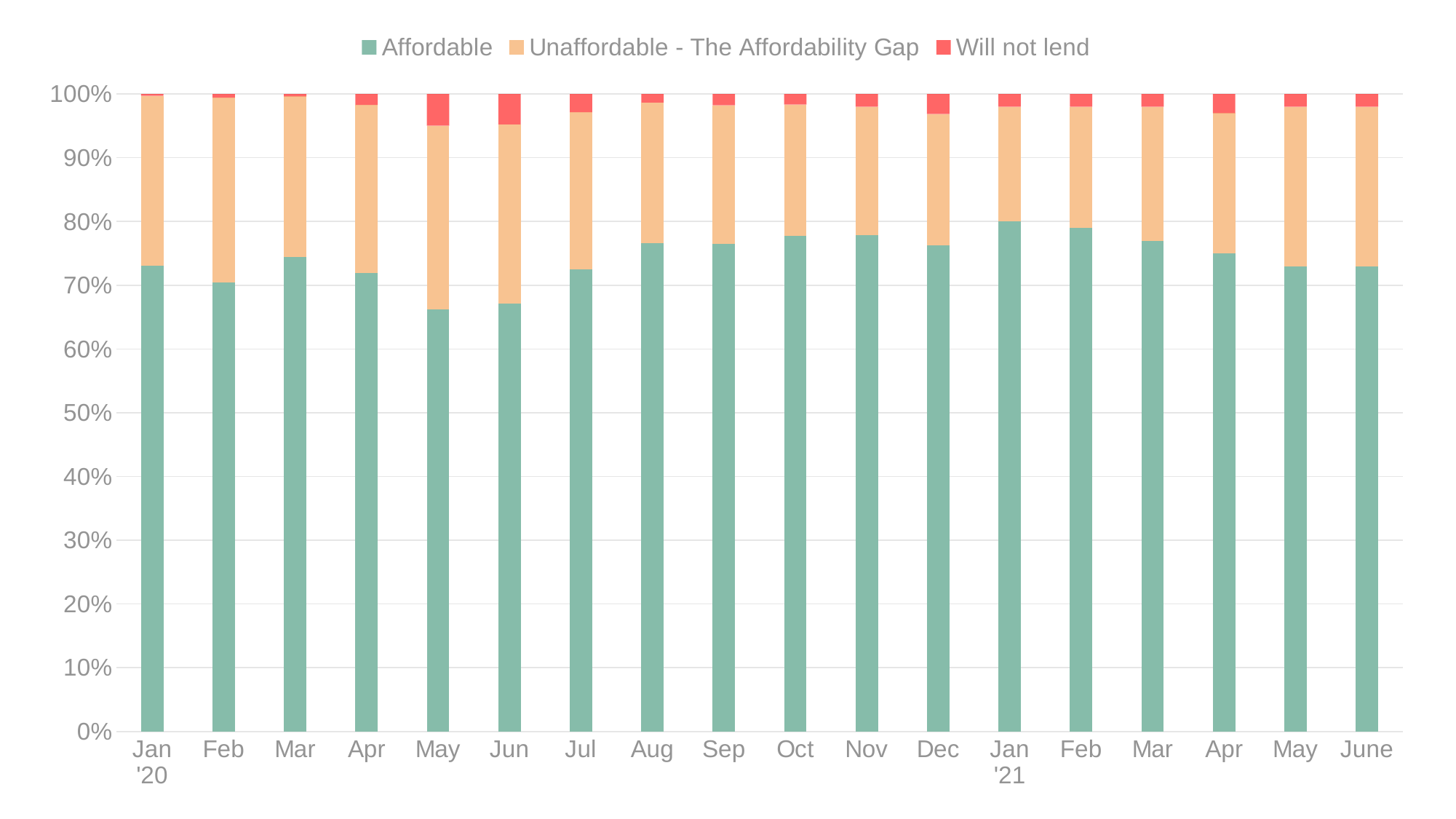
How many series does the legend list? 3 Is the Affordable value for Aug '20 greater or less than 80%? less What is the total of the stacked bar for Jan '20? 100% How many months are plotted along the x axis? 18 Which has the larger Affordable share, Feb '20 or Oct '20? Oct '20 Which has the larger Affordable share, May '20 or Jan '21? Jan '21 Does the Affordable share rise or fall from Jan '21 to June '21? fall Is the Affordable value for Jan '21 greater or less than 70%? greater Is the Affordable value for Jan '20 greater or less than 60%? greater What kind of chart is shown on the slide? stacked bar chart Which series is shown in red in the legend? Will not lend